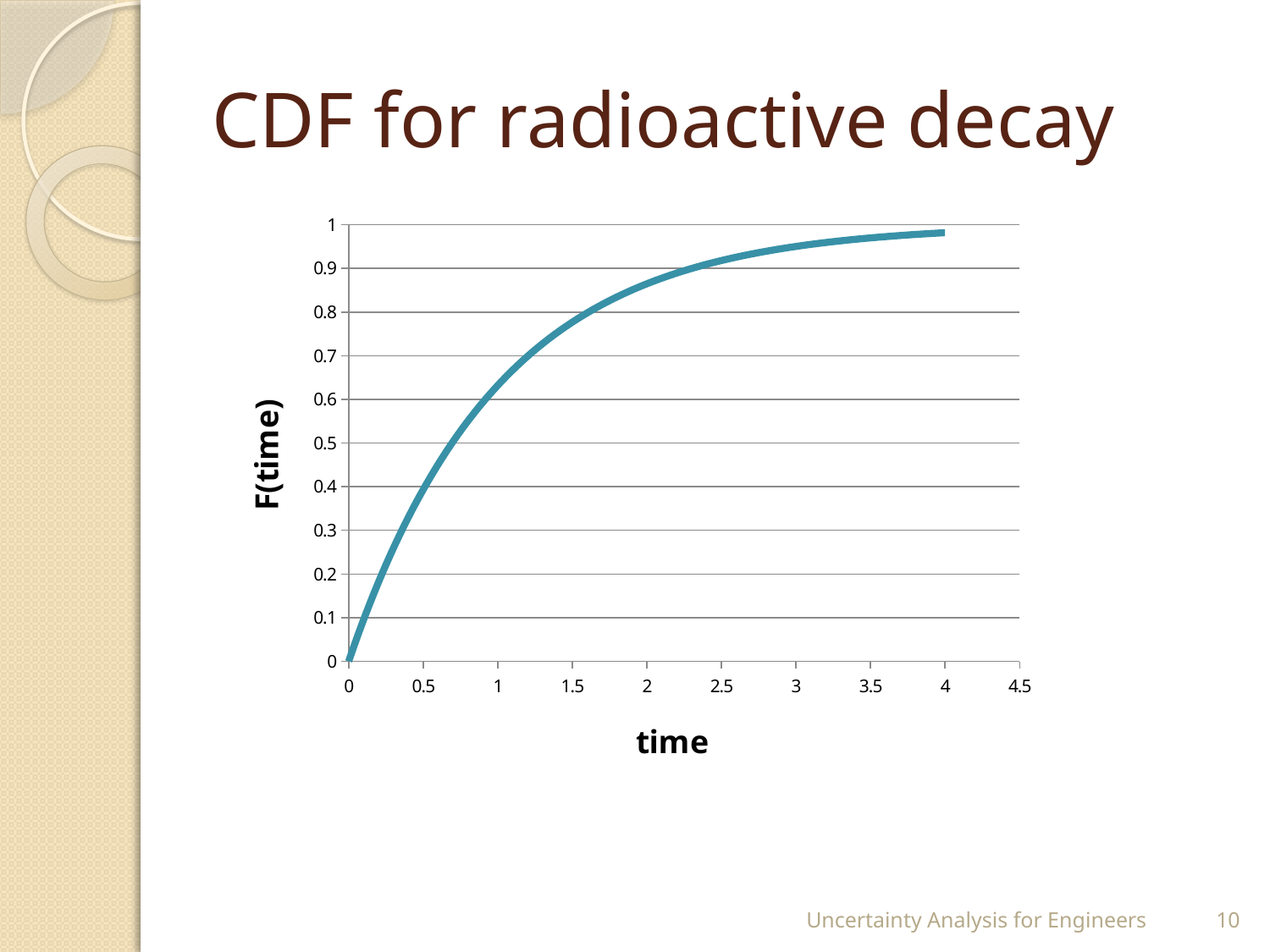
Is the value of F(time) at time 4 greater or less than 0.9? greater Which is larger, F(time) at time 1 or F(time) at time 3? time 3 Is the value of F(time) at time 3 greater or less than 0.9? greater Is the value of F(time) at time 1 greater or less than 0.6? greater What is the value of F(time) at time 0? 0 What is the title of the chart? CDF for radioactive decay Does F(time) rise or fall as time increases along the x axis? rises What is the label of the vertical axis? F(time) What kind of chart is shown on the slide? line chart